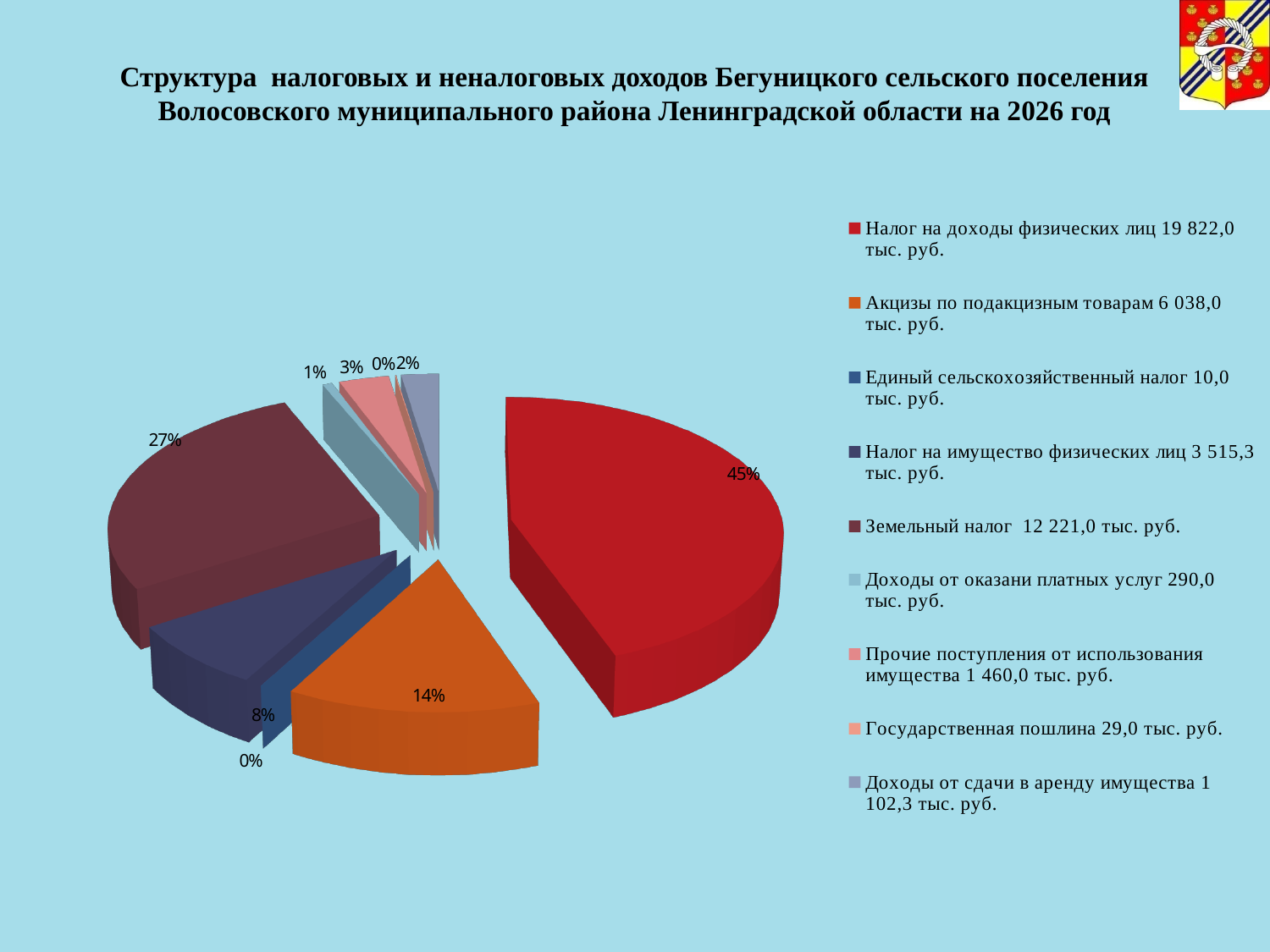
What share of the pie does "Земельный налог" represent? 27% How many entries does the legend list? 9 What amount in тыс. руб. does the legend give for "Земельный налог"? 12 221,0 тыс. руб. For which year does the slide title say the revenue structure is shown? 2026 What share of the pie does "Налог на имущество физических лиц" represent? 8% What share of the pie does "Прочие поступления от использования имущества" represent? 3% Which category has the largest share of the pie? Налог на доходы физических лиц What kind of chart is shown on the slide? pie chart What is the difference in percentage points between the shares of "Налог на доходы физических лиц" (45%) and "Земельный налог" (27%)? 18 percentage points Which has the larger share: "Акцизы по подакцизным товарам" or "Налог на имущество физических лиц"? Акцизы по подакцизным товарам